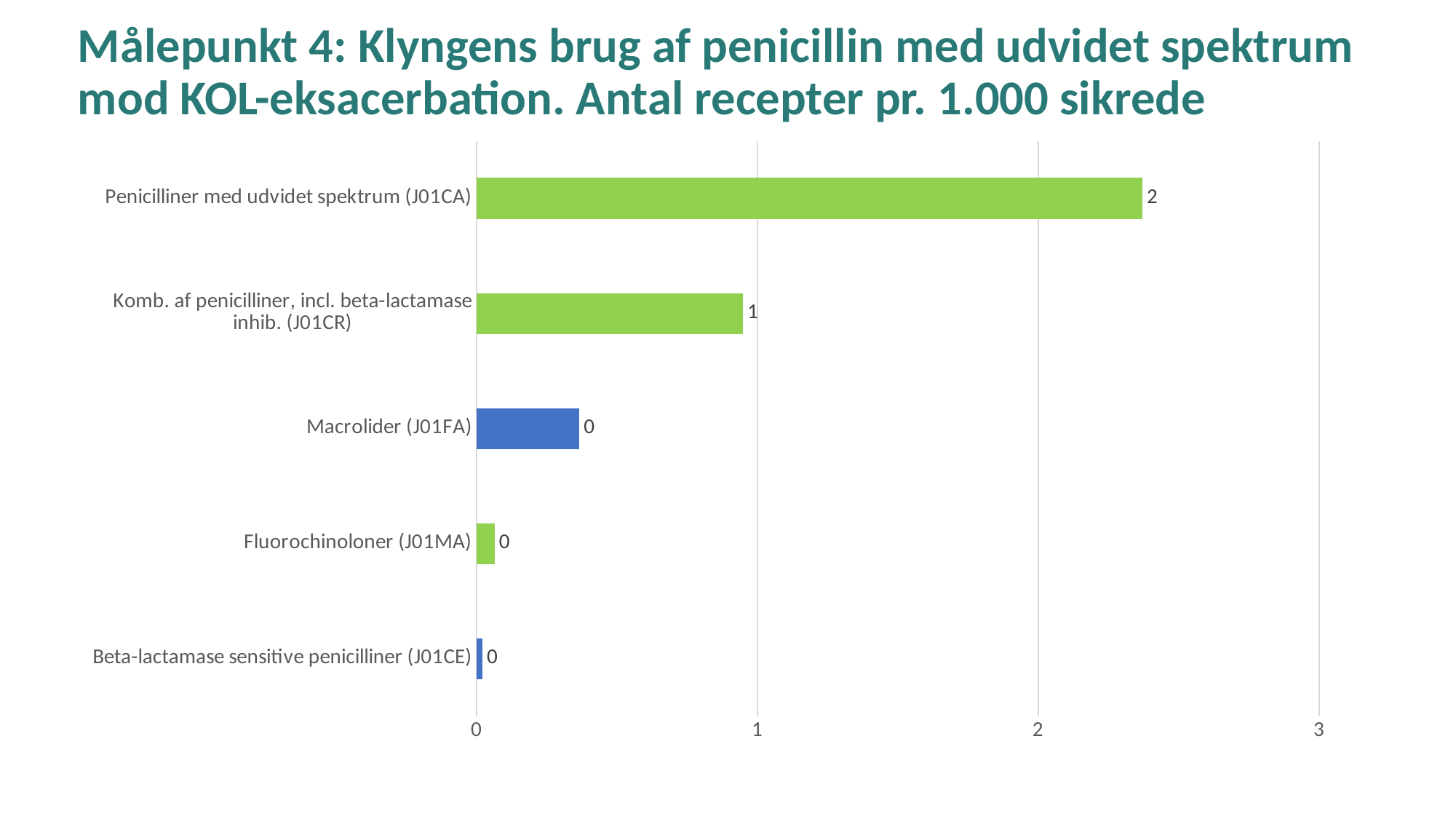
What is the data label shown for Penicilliner med udvidet spektrum (J01CA)? 2 What is the highest value shown on the horizontal axis? 3 What is the data label shown for Macrolider (J01FA)? 0 What colour is the bar for Macrolider (J01FA)? blue What kind of chart is shown on the slide? bar chart Is the value for Komb. af penicilliner, incl. beta-lactamase inhib. (J01CR) greater or less than 1? less How many categories are shown in the chart? 5 What is the data label shown for Komb. af penicilliner, incl. beta-lactamase inhib. (J01CR)? 1 Which category has the lowest value? Beta-lactamase sensitive penicilliner (J01CE) Which category has the highest value? Penicilliner med udvidet spektrum (J01CA) Which is larger: the value for Komb. af penicilliner, incl. beta-lactamase inhib. (J01CR) or the value for Macrolider (J01FA)? Komb. af penicilliner, incl. beta-lactamase inhib. (J01CR) Is the value for Penicilliner med udvidet spektrum (J01CA) greater or less than 2? greater